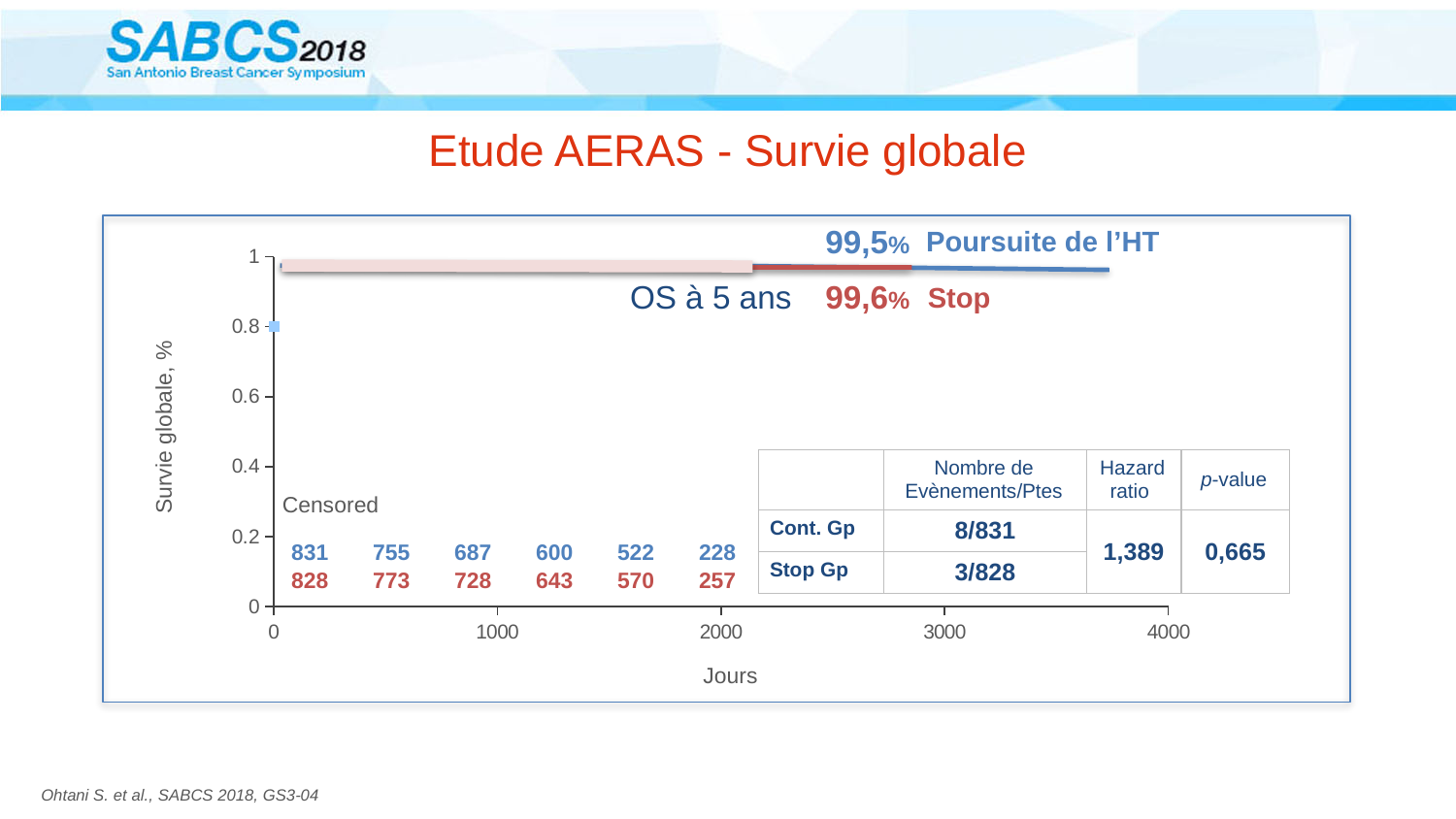
What is the label of the y axis of the chart? Survie globale, % What is the p-value shown in the table? 0,665 What is the difference in 5-year overall survival between the Stop group and the Poursuite de l'HT group? 0,1% Which group has the higher 5-year overall survival, Poursuite de l'HT or Stop? Stop What is the 5-year overall survival (OS à 5 ans) for the Stop group? 99,6% What is the label of the x axis of the chart? Jours What is the hazard ratio shown in the table? 1,389 What is the 5-year overall survival (OS à 5 ans) for the Poursuite de l'HT group? 99,5% How many groups (curves) are plotted on the survival chart? 2 What is the number of events/patients (Nombre de Evènements/Ptes) for the Stop Gp? 3/828 What kind of chart is shown on the slide? Line chart (survival curve) What is the number of events/patients (Nombre de Evènements/Ptes) for the Cont. Gp? 8/831